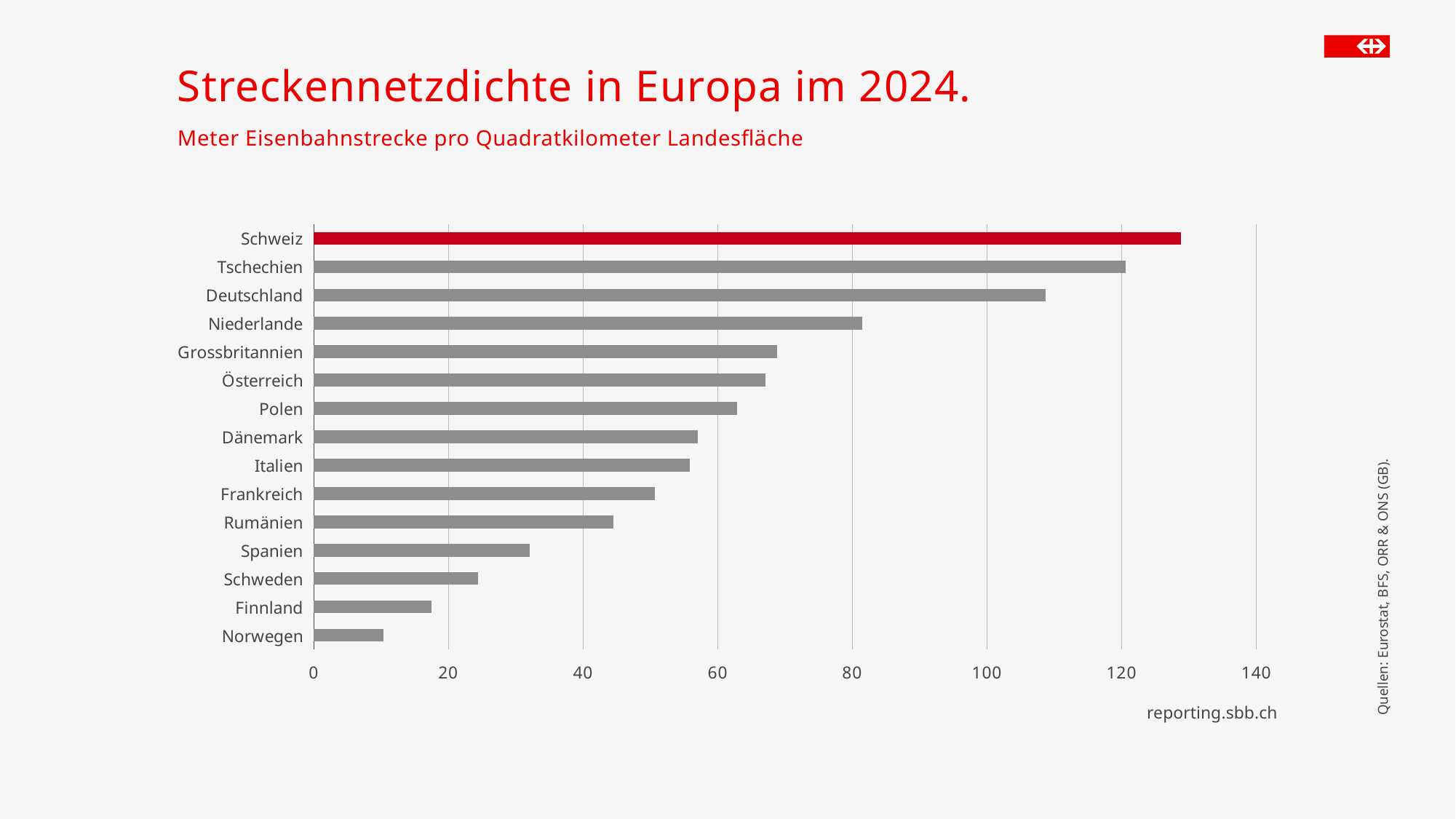
What is the title of the chart? Streckennetzdichte in Europa im 2024. Is the value for Spanien greater or less than 40? less What kind of chart is shown on the slide? bar chart How many countries are shown in the chart? 15 Which country has the lowest value in the chart? Norwegen Is the value for Norwegen greater or less than 20? less Which country has the highest value in the chart? Schweiz Is the value for Schweiz greater or less than 120? greater Which has a larger value, Schweden or Rumänien? Rumänien Which has a larger value, Deutschland or Niederlande? Deutschland